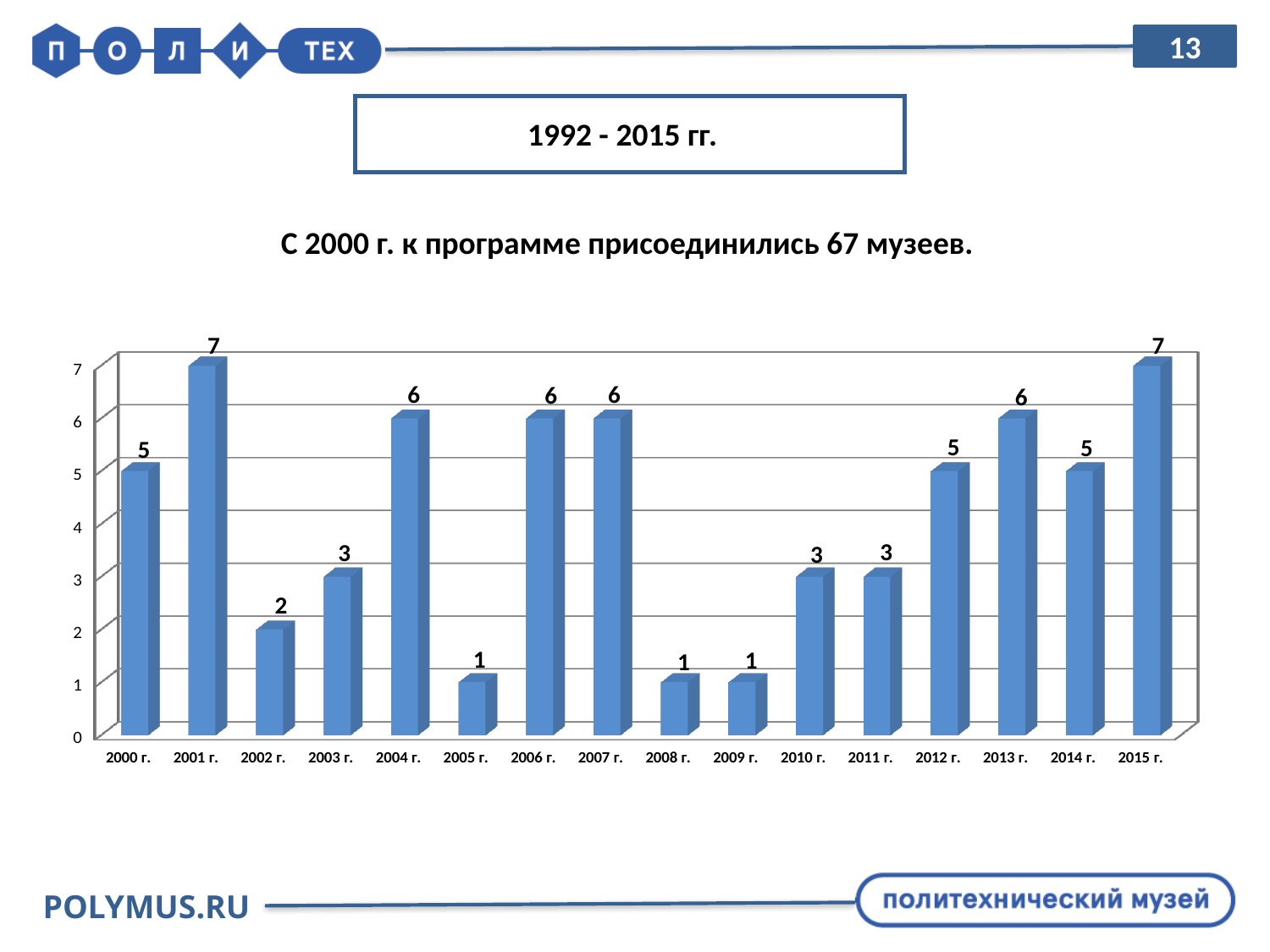
What is the value for 2012 г.? 5 How many years (categories) are shown on the x axis? 16 Which is larger, the value for 2004 г. or the value for 2003 г.? 2004 г. What kind of chart is shown on the slide? Bar chart What period is stated in the box at the top of the slide? 1992 - 2015 гг. What is the difference between the values for 2001 г. and 2002 г.? 5 What is the lowest value shown on the chart? 1 Which years have the highest value on the chart? 2001 г. and 2015 г. What is the value for 2005 г.? 1 What is the value for 2001 г.? 7 What is the value for 2002 г.? 2 Do the values rise or fall from 2008 г. to 2013 г.? Rise